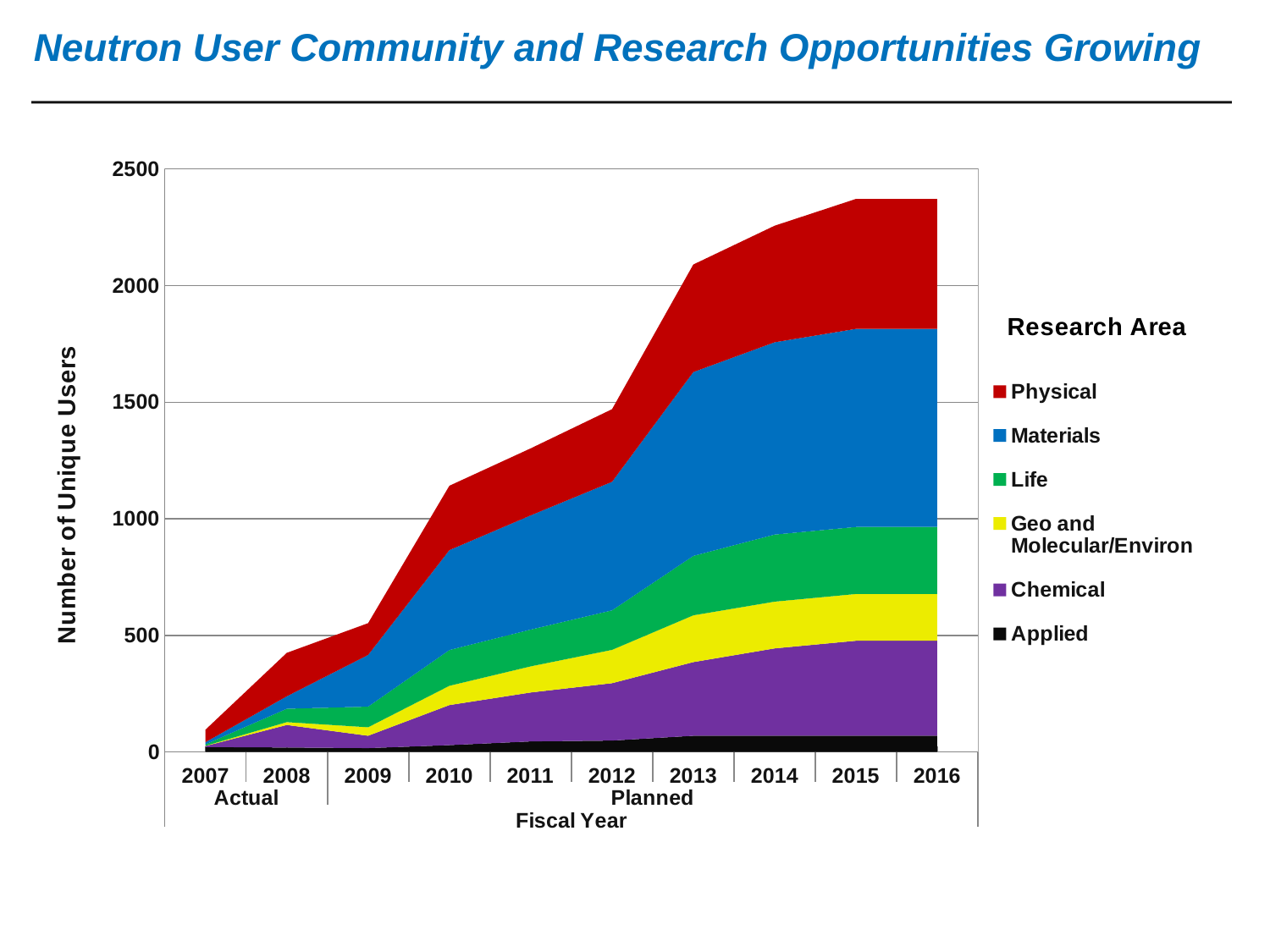
Which fiscal year has the lowest total number of unique users? 2007 How many series does the legend list? 6 Is the total number of unique users in 2011 greater or less than 1500? less Does the total number of unique users generally rise or fall from 2007 to 2016? rise Is the total number of unique users in 2016 greater or less than 2000? greater What kind of chart is shown on the slide? stacked area chart Is the total number of unique users in 2010 greater or less than 1000? greater What is the label of the y axis? Number of Unique Users What is the title of the legend? Research Area How many fiscal years are plotted along the x axis? 10